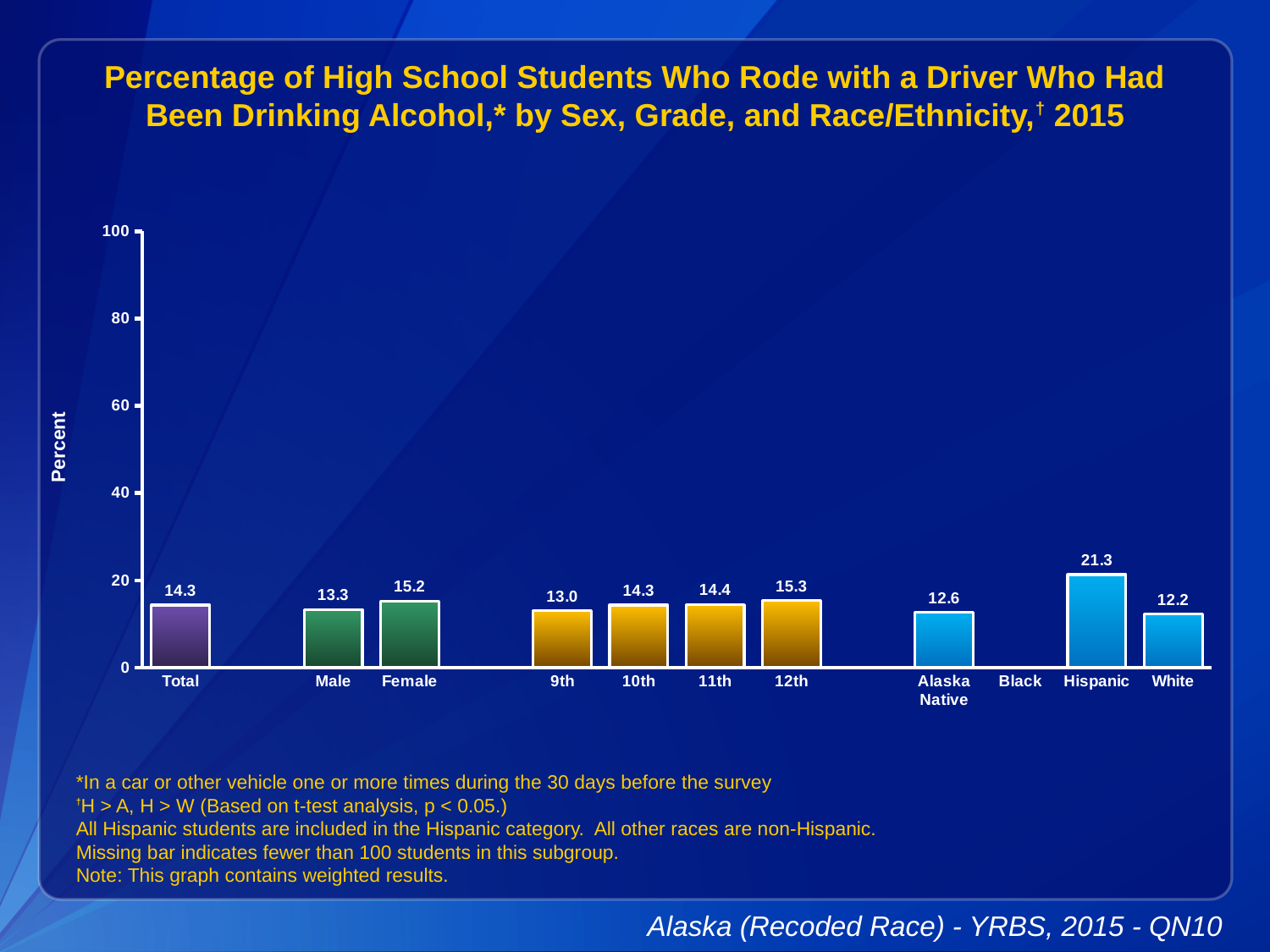
Which category has the lowest value among the bars shown? White Do the values rise or fall from 9th grade to 12th grade? rise What is the value for Hispanic? 21.3 Which category has the highest value? Hispanic Which is larger, the value for 12th grade or the value for 11th grade? 12th What kind of chart is this? bar chart Is the value for Hispanic greater or less than 20? greater Which category has no bar shown? Black How many categories are labeled on the x axis? 11 What is the value for Total? 14.3 What is the value for 9th grade? 13.0 What is the difference between the Female and Male values? 1.9